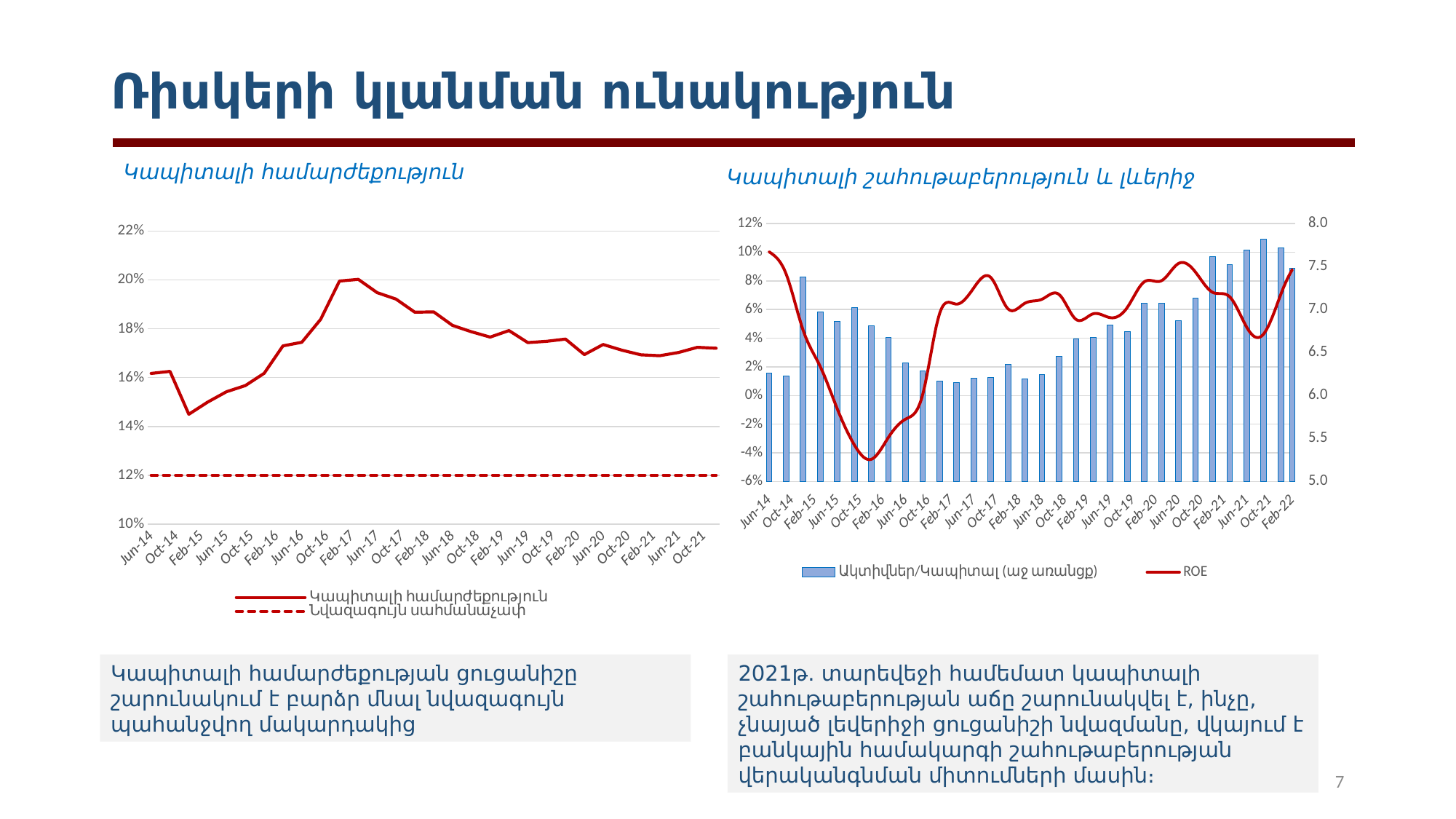
In the left chart, how many series does the legend list? 2 In the right chart, is the ROE value at Feb-16 greater or less than 5.5 on the right axis? less In the left chart, at which date does the capital adequacy line reach its highest point? Feb-17 In the left chart, at which date does the capital adequacy line reach its lowest point? Feb-15 In the right chart, which date has the tallest bar for Ակտիվներ/Կապիտալ (աճ առանցք)? Oct-21 In the left chart, is the capital adequacy value at Feb-15 greater or less than 16%? less In the left chart, does the capital adequacy line rise or fall from Feb-17 to Oct-21? fall What kind of chart is the left chart titled "Կապիտալի համարժեքություն"? line chart In the left chart, at what level does the dashed minimum threshold line (Նվազագույն սահմանաչափ) sit? 12% What kind of chart is the right chart titled "Կապիտալի շահութաբերություն և լևերիջ"? combined bar and line chart In the left chart, is the capital adequacy value at Feb-17 greater or less than 18%? greater In the right chart, how many series does the legend list? 2